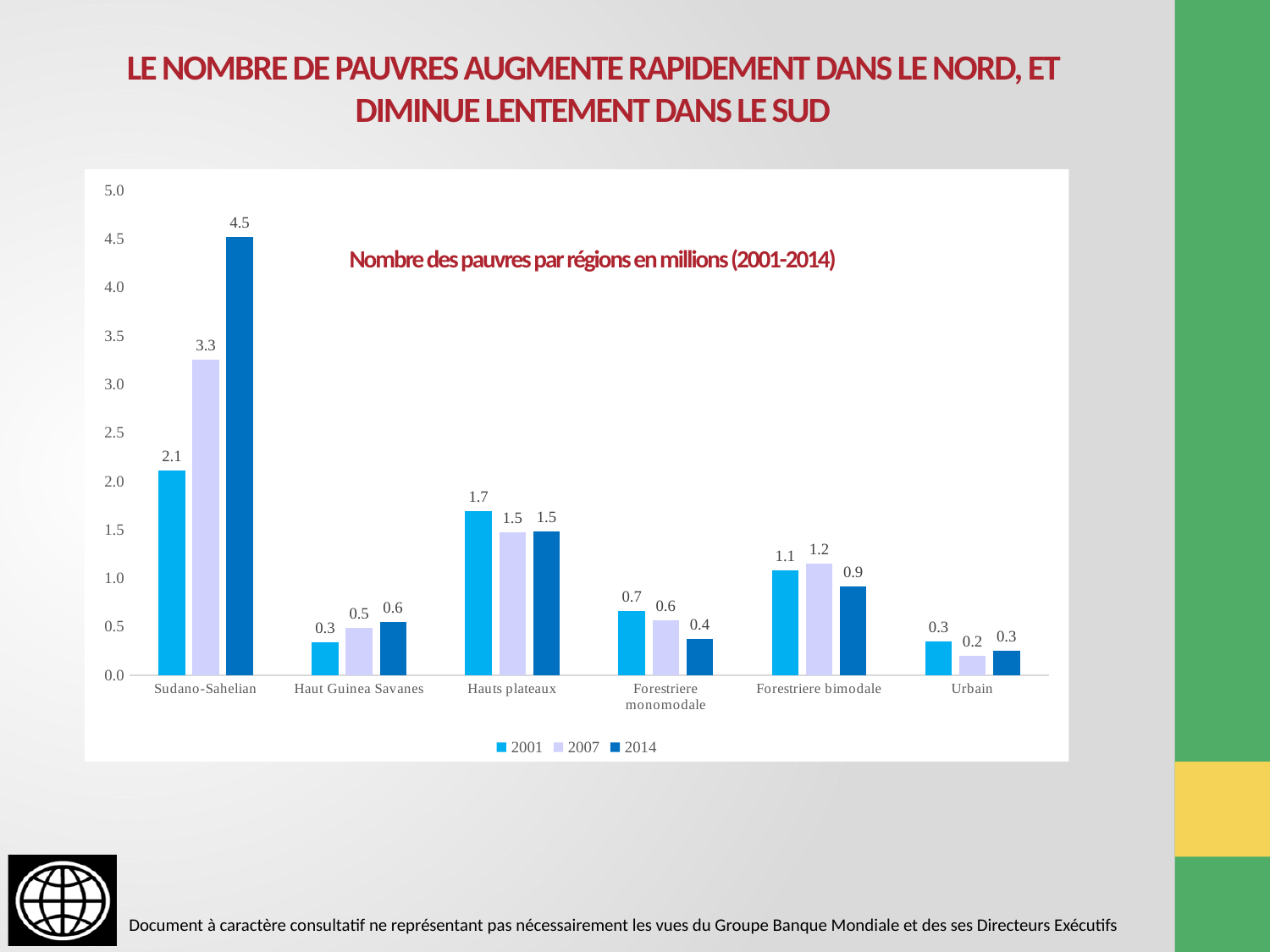
Which is larger for Forestriere monomodale: the 2001 value or the 2014 value? 2001 Which region has the highest value in 2014? Sudano-Sahelian What kind of chart is shown on the slide? Bar chart How many regions are shown on the x axis? 6 What is the difference between the 2014 and 2001 values for Sudano-Sahelian? 2.4 What is the title of the chart? Nombre des pauvres par régions en millions (2001-2014) What is the value for Forestriere bimodale in 2007? 1.2 How many series does the legend list? 3 What is the value for Hauts plateaux in 2001? 1.7 Which region has the lowest value in 2007? Urbain What is the value for Sudano-Sahelian in 2014? 4.5 Do the values for Sudano-Sahelian rise or fall from 2001 to 2014? Rise